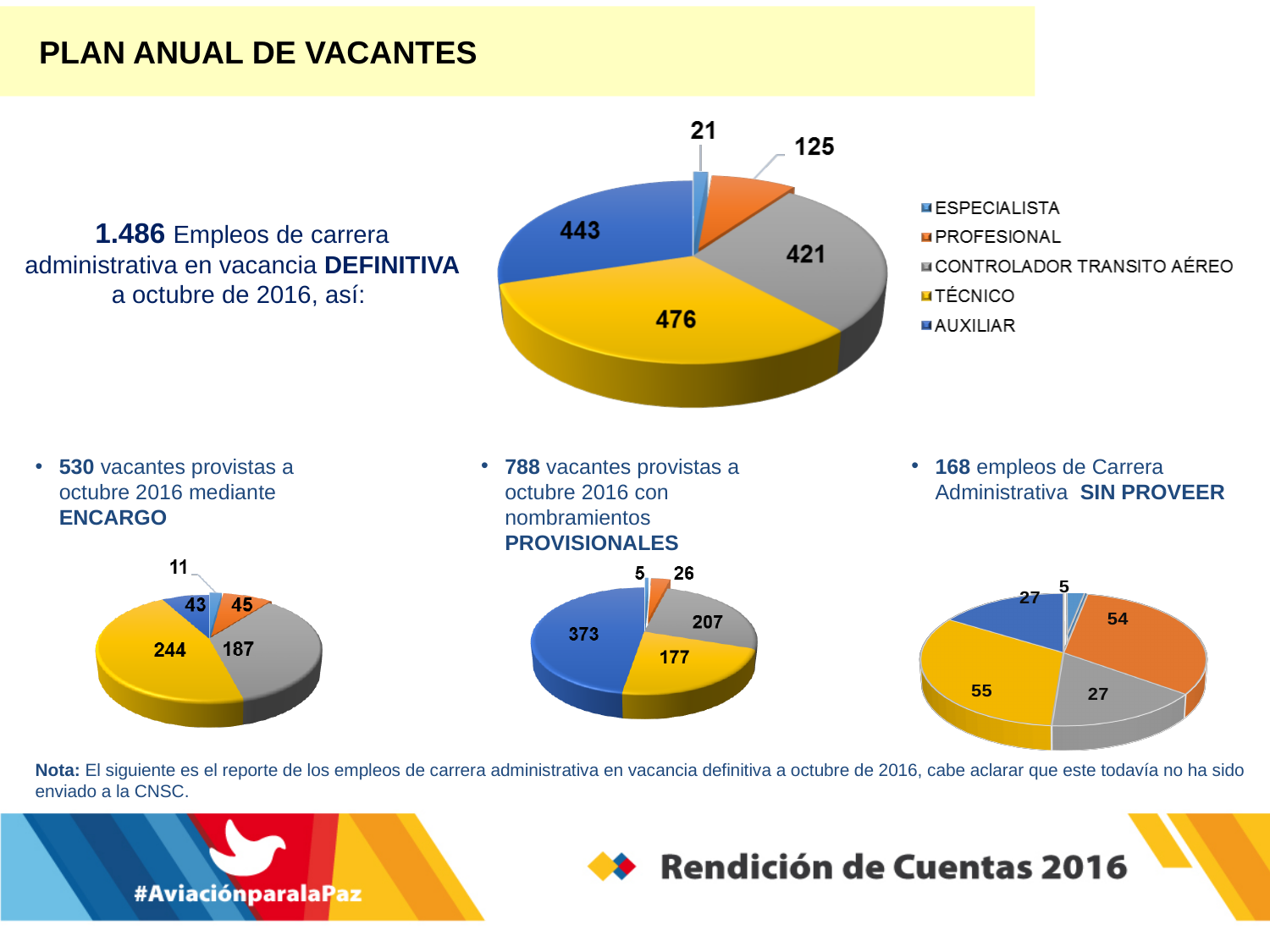
In the large pie chart at the top of the slide, which category has the largest value? TÉCNICO What type of chart is used for the ENCARGO data at the bottom left of the slide? Pie chart In the SIN PROVEER pie chart at the bottom right of the slide, what is the value of the orange slice? 54 In the ENCARGO pie chart at the bottom left of the slide, what is the largest value shown? 244 In the large pie chart at the top of the slide, what is the difference between the values for AUXILIAR and CONTROLADOR TRANSITO AÉREO? 22 In the large pie chart at the top of the slide, which is larger: the value for AUXILIAR or the value for PROFESIONAL? AUXILIAR In the PROVISIONALES pie chart at the bottom centre of the slide, what is the value of the blue slice? 373 In the large pie chart at the top of the slide, what is the value for PROFESIONAL? 125 In the PROVISIONALES pie chart at the bottom centre of the slide, what is the smallest value shown? 5 In the large pie chart at the top of the slide, which category has the smallest value? ESPECIALISTA In the large pie chart at the top of the slide, what is the value for TÉCNICO? 476 How many categories does the legend of the large pie chart at the top of the slide list? 5